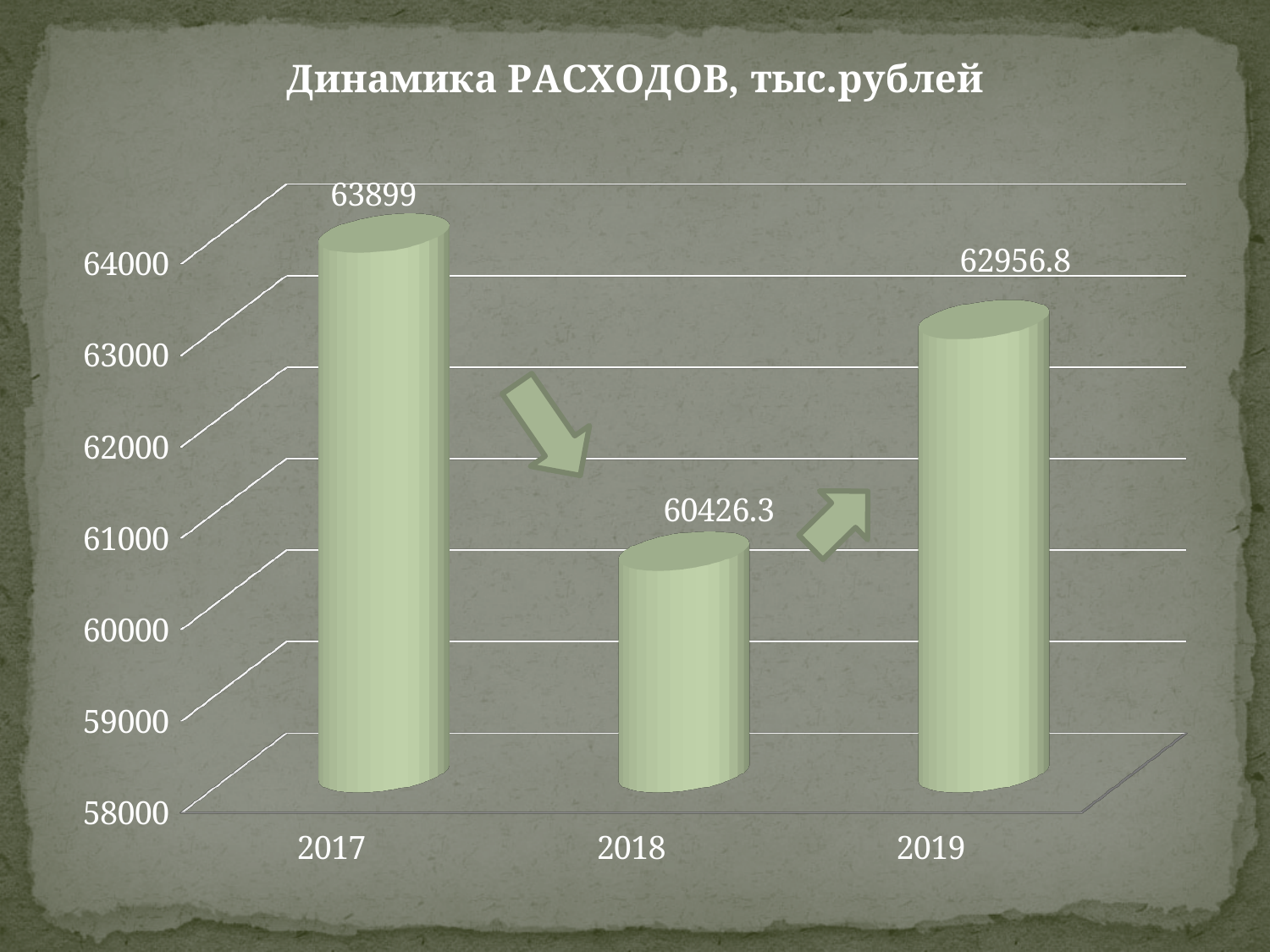
What is the value for 2017? 63899 Which year has the highest value? 2017 Which year has the lowest value? 2018 Which is larger, the value for 2017 or the value for 2019? 2017 Is the value for 2018 greater or less than 61000? less What is the value for 2019? 62956.8 What is the difference between the values for 2019 and 2018? 2530.5 What kind of chart is shown on the slide? bar chart What is the title of the chart? Динамика РАСХОДОВ, тыс.рублей What is the difference between the values for 2017 and 2018? 3472.7 What is the value for 2018? 60426.3 How many years are shown on the chart? 3